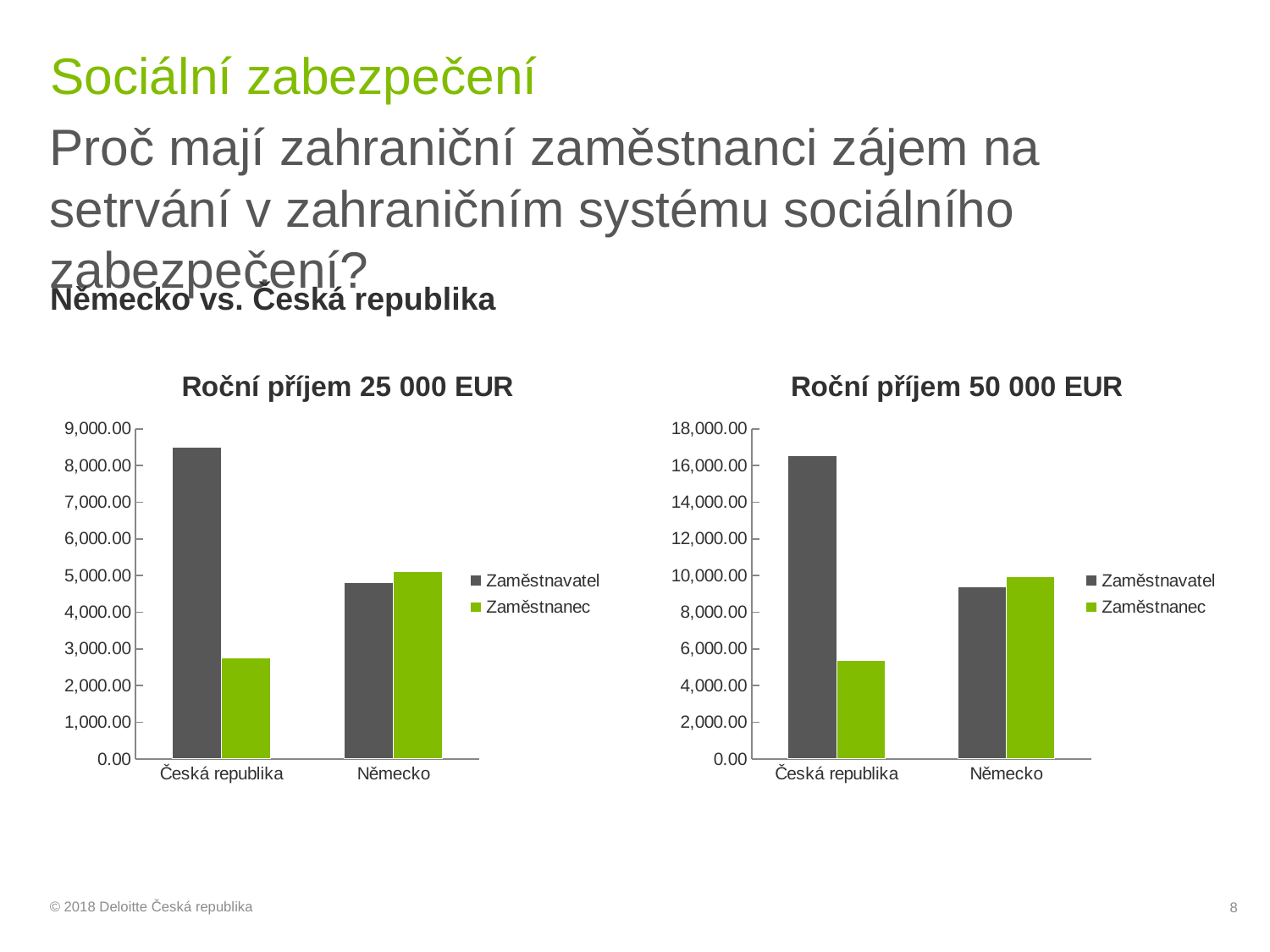
In the chart titled "Roční příjem 50 000 EUR", which bar is the tallest? Zaměstnavatel for Česká republika How many series does the legend of the chart titled "Roční příjem 50 000 EUR" list? 2 In the chart titled "Roční příjem 50 000 EUR", is the Zaměstnavatel value for Česká republika greater or less than 16,000.00? greater In the chart titled "Roční příjem 25 000 EUR", is the Zaměstnanec value for Česká republika greater or less than 3,000.00? less Which colour represents the Zaměstnanec series in the charts on the slide? green In the chart titled "Roční příjem 50 000 EUR", which is larger for Česká republika: Zaměstnavatel or Zaměstnanec? Zaměstnavatel In the chart titled "Roční příjem 50 000 EUR", is the Zaměstnanec value for Česká republika greater or less than 6,000.00? less In the chart titled "Roční příjem 25 000 EUR", which bar is the shortest? Zaměstnanec for Česká republika What kind of chart is the chart titled "Roční příjem 25 000 EUR"? bar chart How many categories are shown on the x axis of the chart titled "Roční příjem 25 000 EUR"? 2 In the chart titled "Roční příjem 25 000 EUR", which bar is the tallest? Zaměstnavatel for Česká republika